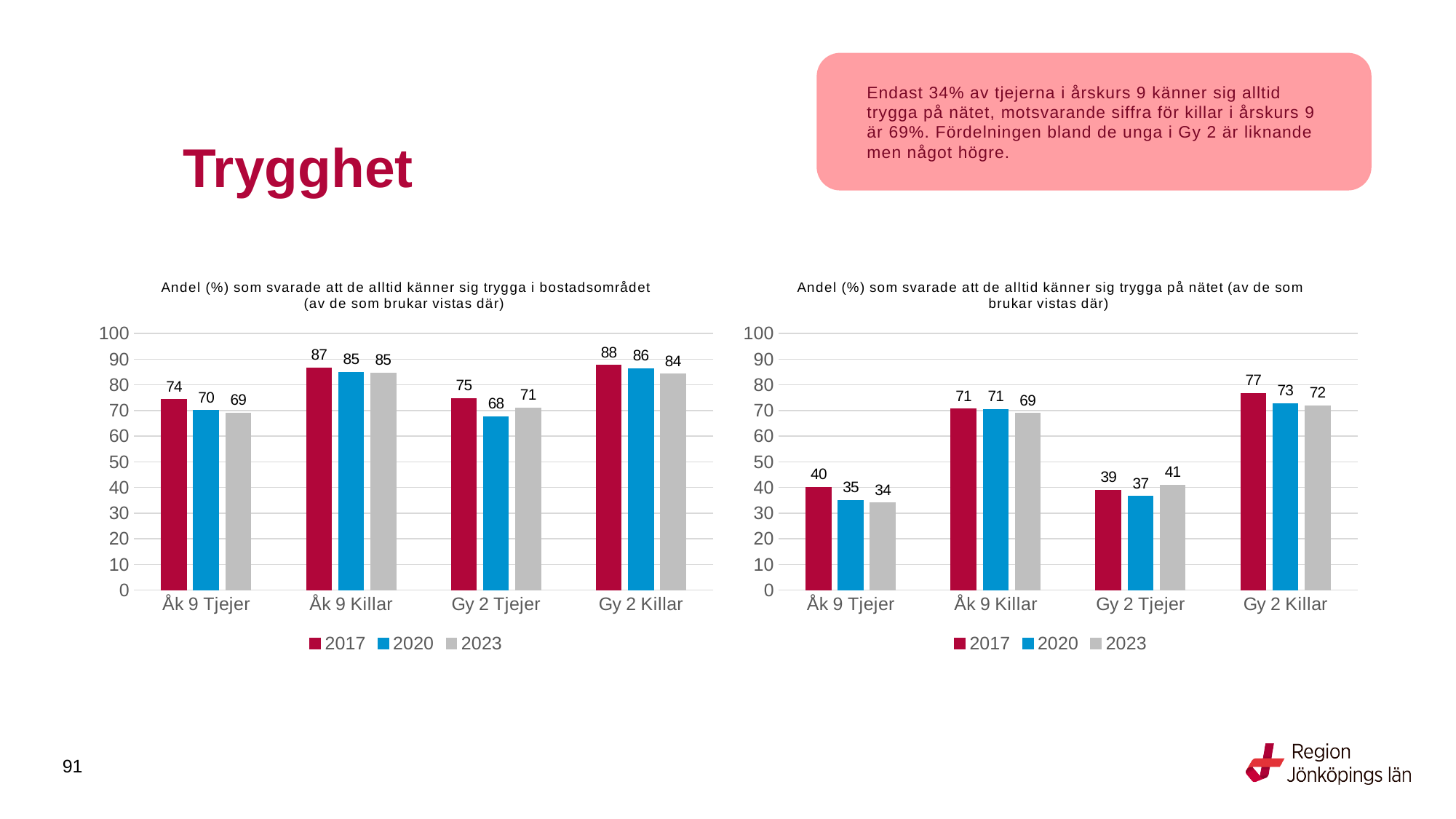
In the left chart (trygga i bostadsområdet), what is the difference between the 2017 and 2023 values for Åk 9 Tjejer? 5 What kind of chart is the left chart (trygga i bostadsområdet)? Bar chart Which years are listed in the legend of the left chart (trygga i bostadsområdet)? 2017, 2020, 2023 In the right chart (trygga på nätet), do the values for Gy 2 Killar rise or fall from 2017 to 2023? Fall In the left chart (trygga i bostadsområdet), what is the value for Åk 9 Killar in 2017? 87 In the right chart (trygga på nätet), is the 2020 value for Åk 9 Killar greater or less than 60? greater In the left chart (trygga i bostadsområdet), which category has the lowest value in 2020? Gy 2 Tjejer In the right chart (trygga på nätet), what is the value for Åk 9 Tjejer in 2023? 34 In the right chart (trygga på nätet), which category has the highest value in 2017? Gy 2 Killar How many series does the legend of the right chart (trygga på nätet) list? 3 In the right chart (trygga på nätet), which is larger: the 2023 value for Gy 2 Tjejer or the 2023 value for Åk 9 Tjejer? Gy 2 Tjejer How many categories are shown on the x axis of the left chart (trygga i bostadsområdet)? 4